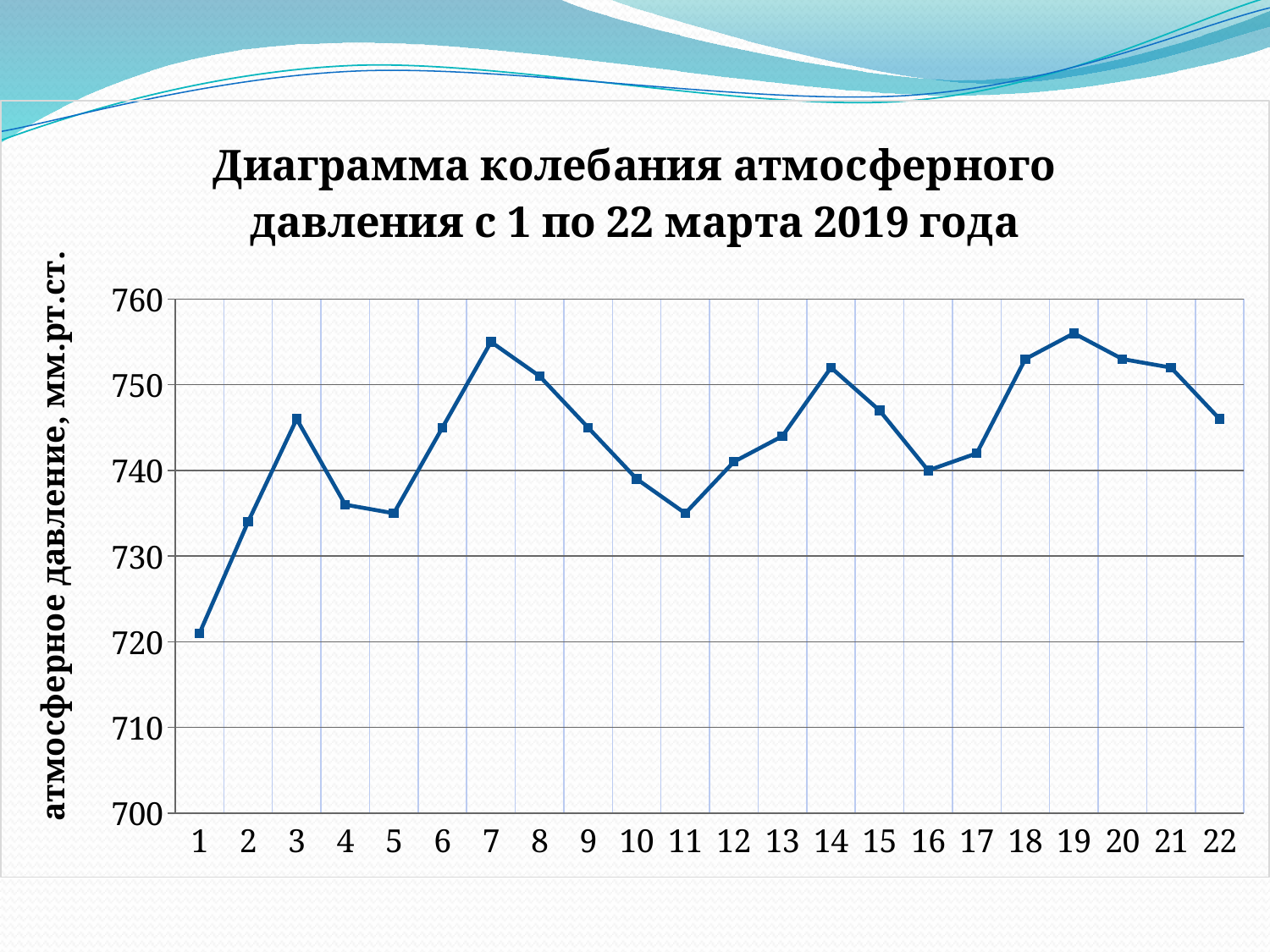
Is the value for day 7 greater or less than 750? greater Which day has the higher atmospheric pressure, day 3 or day 4? day 3 What is the label of the vertical axis? атмосферное давление, мм.рт.ст. Is the value for day 11 greater or less than 740? less Is the value for day 1 greater or less than 730? less Does the atmospheric pressure rise or fall from day 19 to day 22? fall Which day has the higher atmospheric pressure, day 1 or day 22? day 22 What kind of chart is shown on the slide? line chart How many data points (days) are plotted on the chart? 22 On which day is the atmospheric pressure lowest? 1